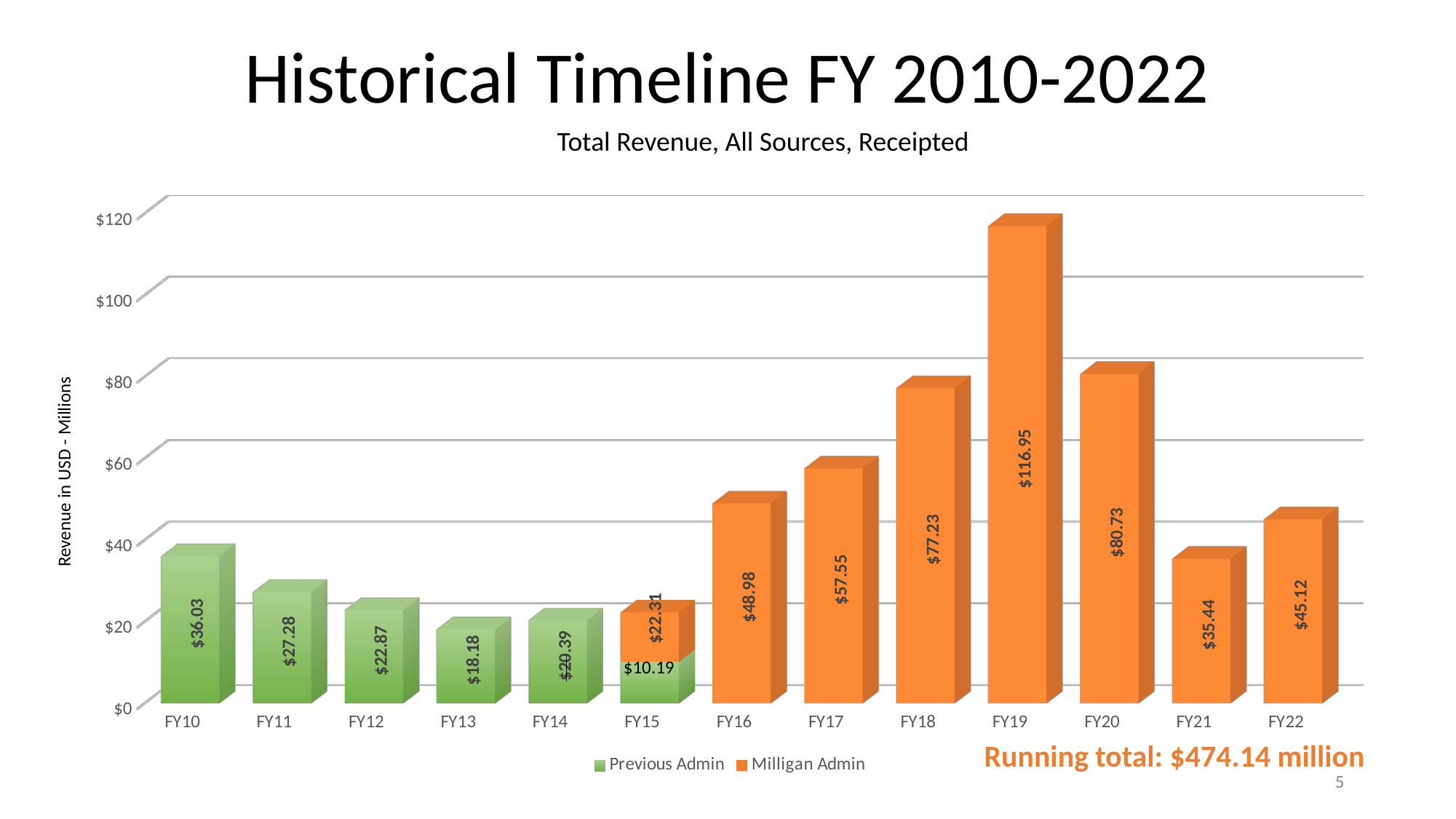
How many series does the legend list? 2 What kind of chart is shown on the slide? Bar chart How many fiscal years are shown on the x axis? 13 Which is larger, the value for FY21 or the value for FY22? FY22 Which fiscal year has the lowest total revenue? FY13 What is the running total stated on the slide? $474.14 million Which fiscal year has the highest revenue? FY19 What is the total of the stacked bar for FY15? $22.31 What is the Previous Admin value shown for FY15? $10.19 What is the revenue value shown for FY19? $116.95 What is the difference between the FY19 and FY20 values? $36.22